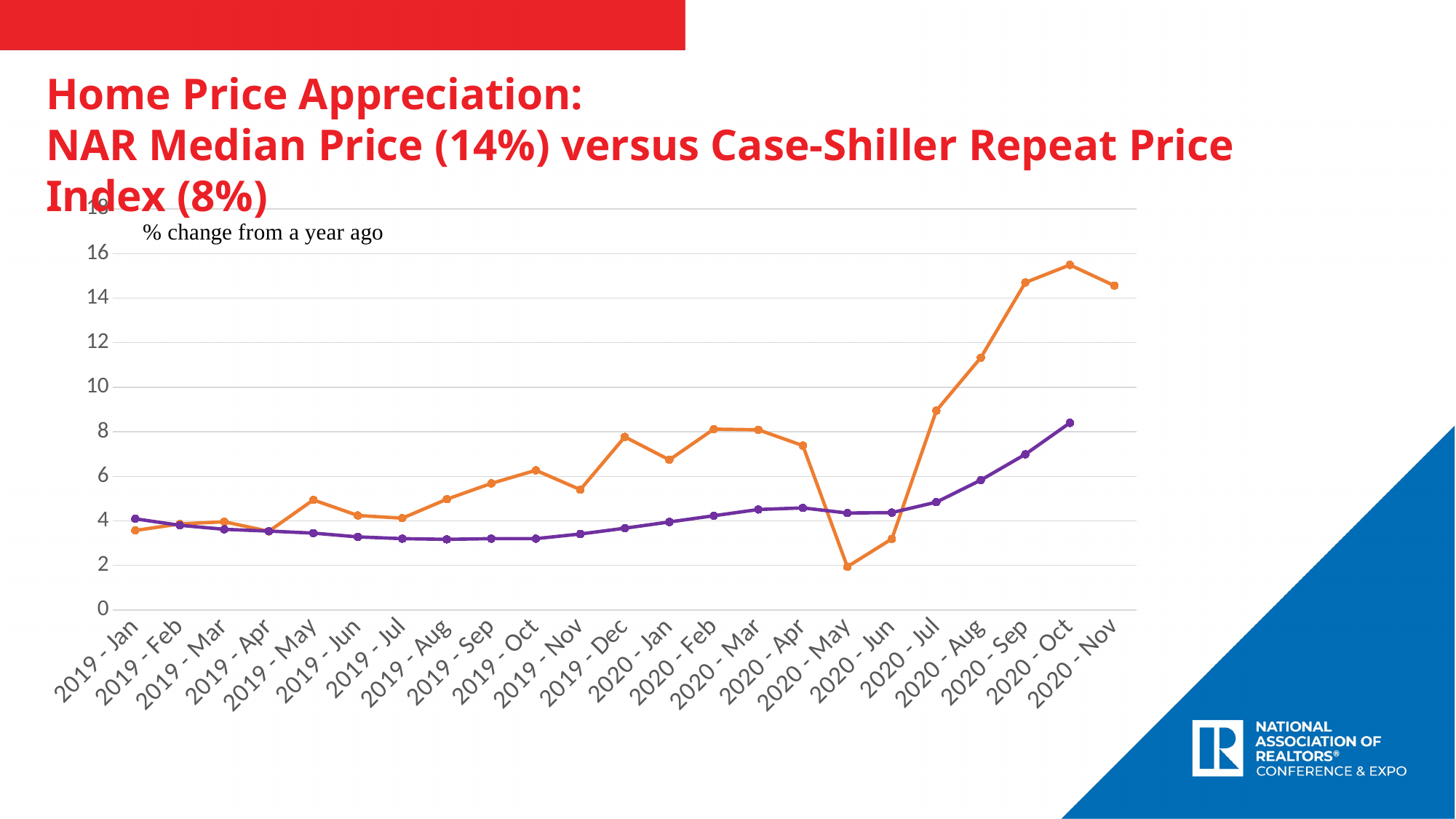
At which month does the orange line reach its lowest value? 2020 - May What unit description is written at the top of the chart area? % change from a year ago How many months are shown along the x axis of the chart? 23 At which month does the orange line reach its highest value? 2020 - Oct How many lines are plotted on the chart? 2 What kind of chart is shown on the slide? line chart At 2020 - May, which line has the higher value, the orange line or the purple line? the purple line Is the value of the orange line at 2020 - May greater or less than 4? less Does the purple line rise or fall between 2020 - Jun and 2020 - Oct? rise Is the value of the orange line at 2020 - Oct greater or less than 14? greater At which month does the purple line reach its highest value? 2020 - Oct Is the value of the purple line at 2019 - Jul greater or less than 4? less